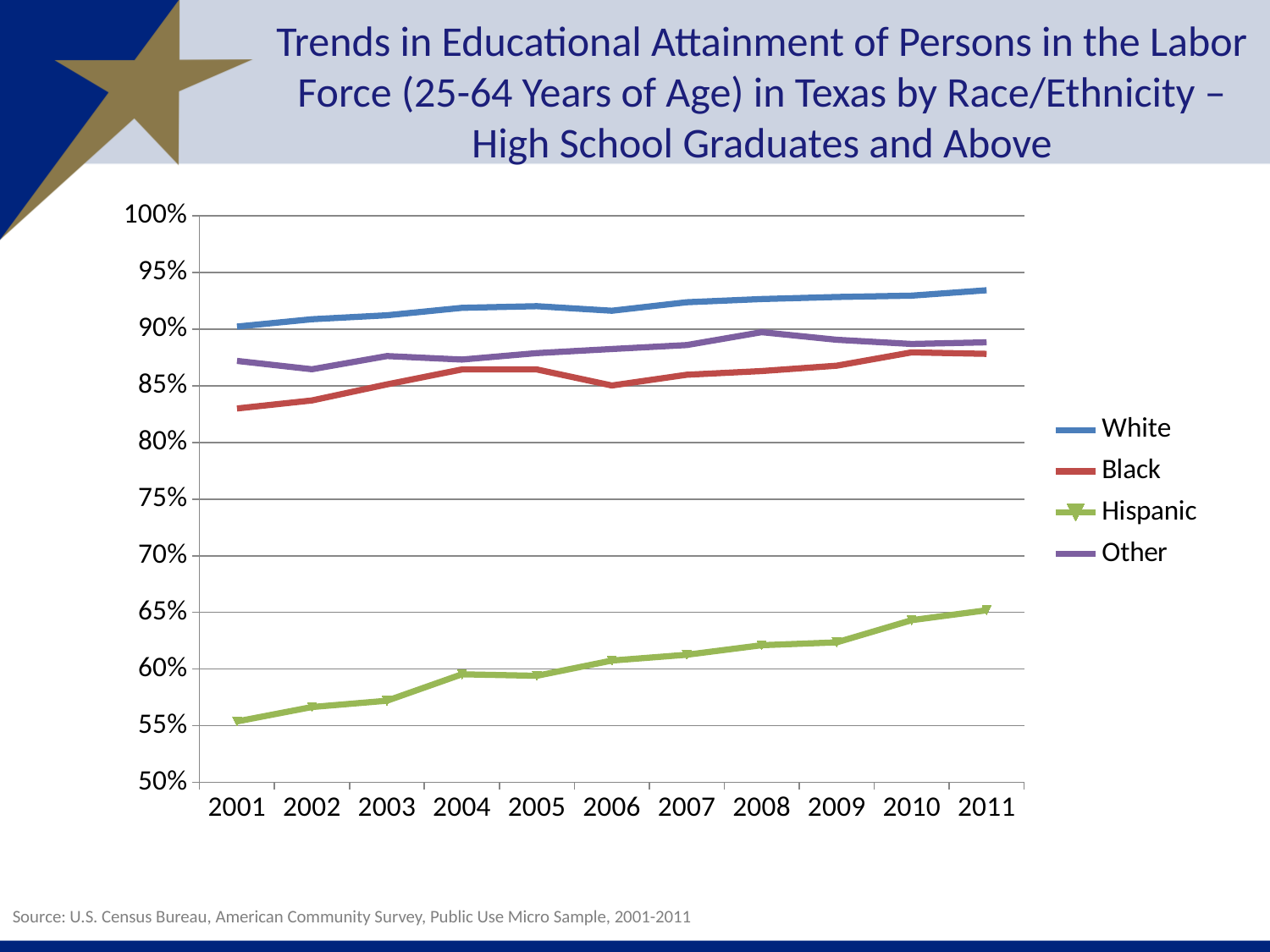
Is the value for Hispanic in 2011 greater or less than 60%? greater How many years are shown along the x axis? 11 Is the value for Hispanic in 2001 greater or less than 60%? less What are the four entries listed in the legend? White, Black, Hispanic, Other Which series has the lowest value in 2011? Hispanic In 2008, which is higher: the value for Other or the value for Black? Other Is the value for White in 2011 greater or less than 90%? greater What kind of chart is shown on the slide? line chart How many series does the legend list? 4 Which series has the highest value in 2011? White Does the Hispanic line rise or fall from 2001 to 2011? rises